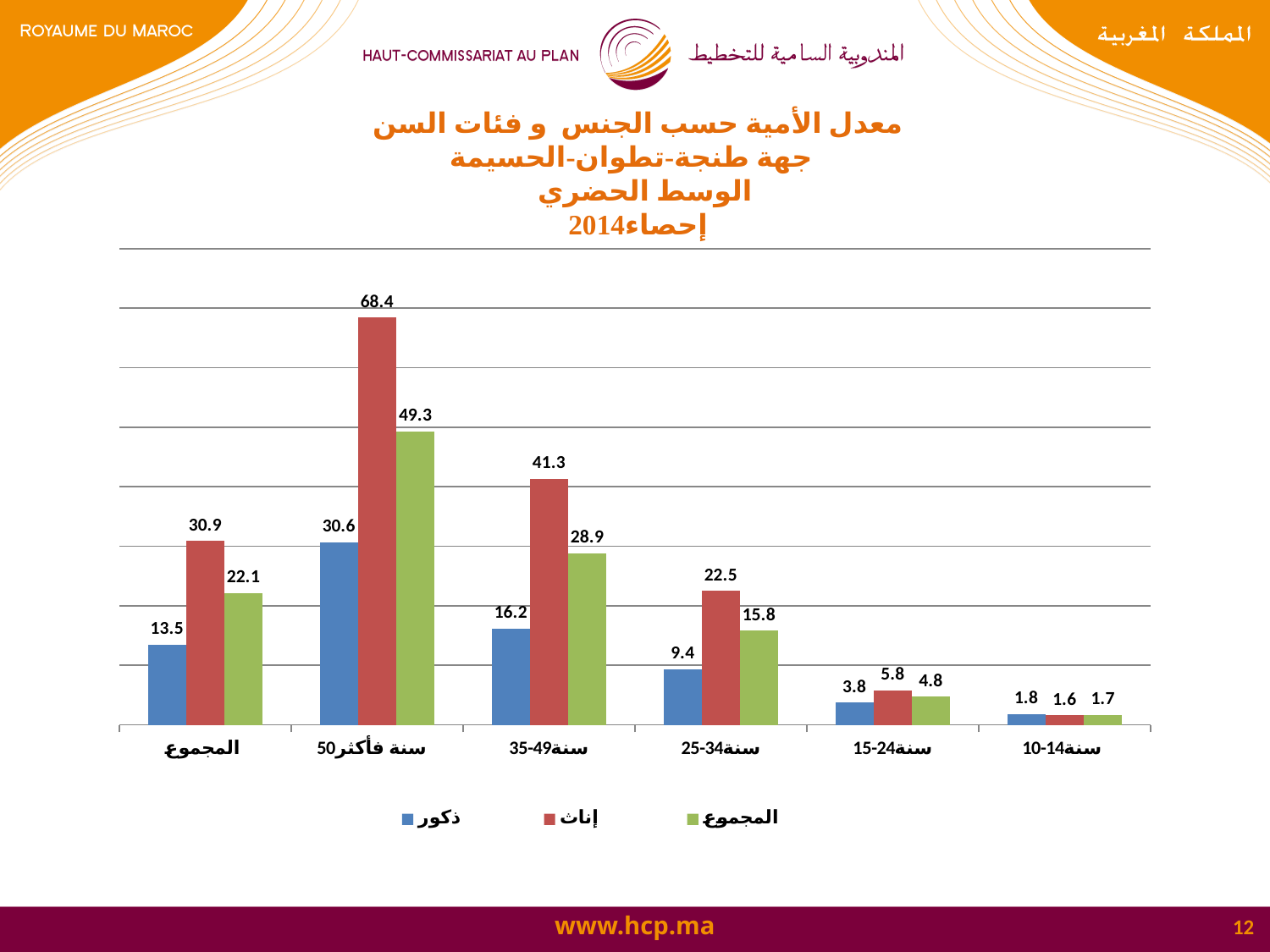
Which series is shown in red in the legend? إناث What is the value for ذكور (males) in the المجموع (total) category? 13.5 What is the value for ذكور (males) in the 25-34 سنة age group? 9.4 What kind of chart is shown on the slide? Bar chart What is the value for إناث (females) in the 50 سنة فأكثر age group? 68.4 How many age-group categories are shown on the x axis? 6 In the 15-24 سنة age group, which is larger: the value for ذكور (males) or إناث (females)? إناث How many series does the legend list? 3 Which age group has the lowest value for ذكور (males)? 10-14 سنة Which age group has the highest value for إناث (females)? 50 سنة فأكثر What is the value for المجموع (total) series in the 35-49 سنة age group? 28.9 What is the difference between the إناث (females) and ذكور (males) values in the 50 سنة فأكثر age group? 37.8